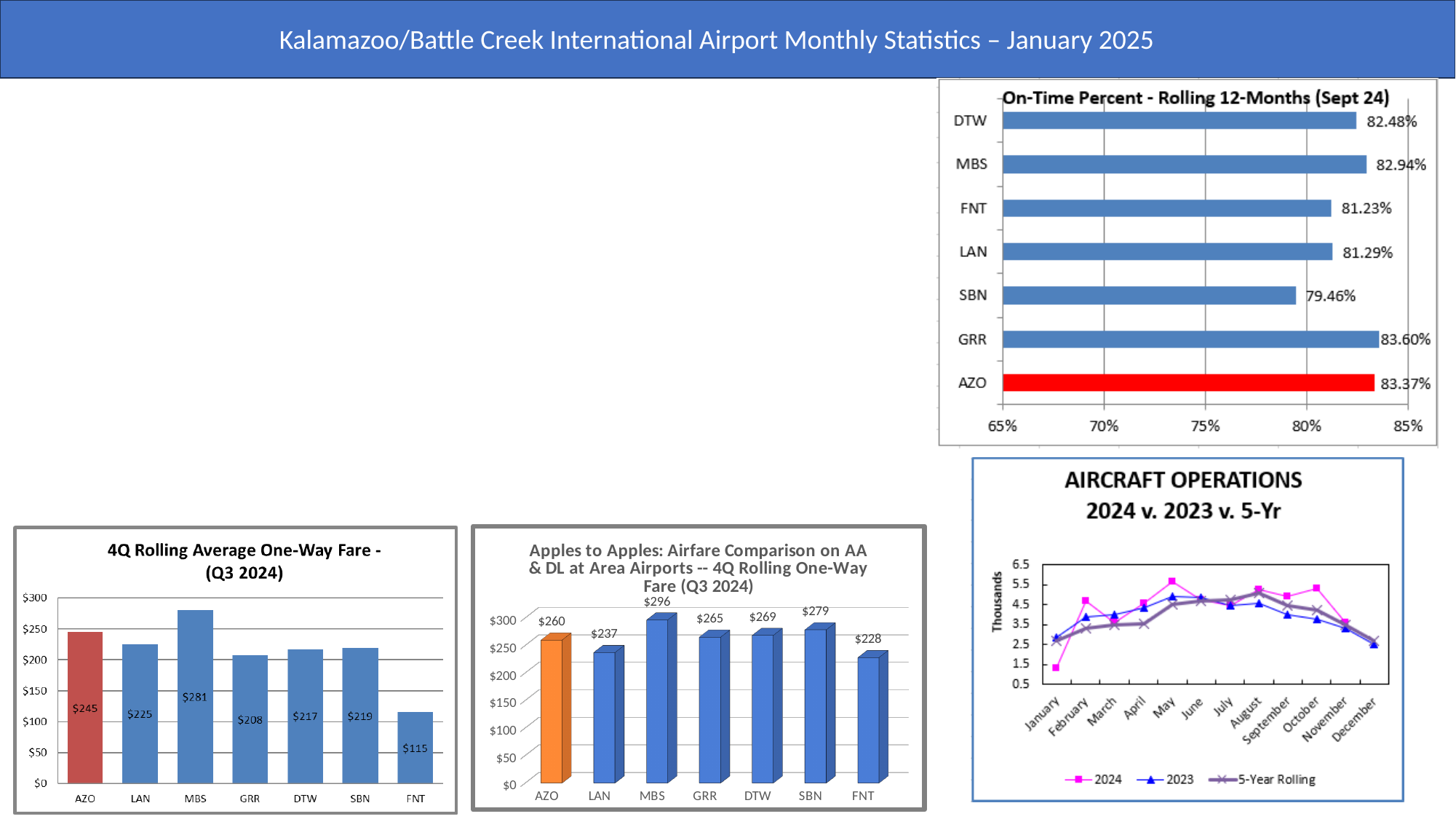
In the On-Time Percent - Rolling 12-Months (Sept 24) chart, which airport has the highest on-time percent? GRR In the 4Q Rolling Average One-Way Fare (Q3 2024) chart, what is the difference between the AZO fare and the LAN fare? $20 In the 4Q Rolling Average One-Way Fare (Q3 2024) chart, what is the fare for MBS? $281 In the On-Time Percent - Rolling 12-Months (Sept 24) chart, how many airports are shown? 7 In the Aircraft Operations chart, how many series does the legend list? 3 What kind of chart is the Aircraft Operations 2024 v. 2023 v. 5-Yr chart? line chart In the Apples to Apples airfare comparison chart, which is larger, the fare for GRR or the fare for DTW? DTW In the Apples to Apples airfare comparison chart, what is the fare for SBN? $279 In the On-Time Percent - Rolling 12-Months (Sept 24) chart, what is the on-time percent for AZO? 83.37% In the On-Time Percent - Rolling 12-Months (Sept 24) chart, which airport has the lowest on-time percent? SBN In the Apples to Apples airfare comparison chart, which airport has the highest fare? MBS In the 4Q Rolling Average One-Way Fare (Q3 2024) chart, which airport has the lowest fare? FNT